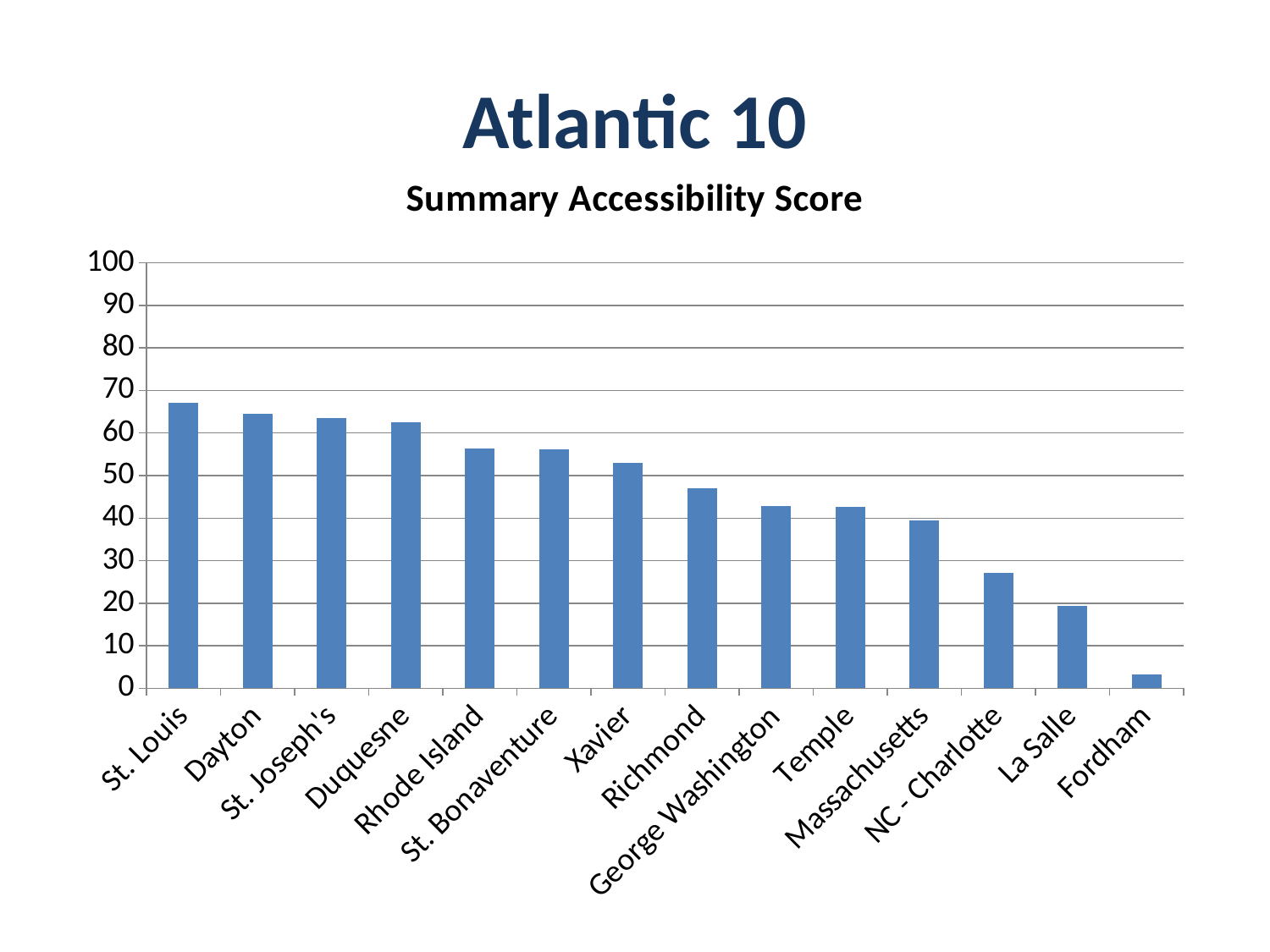
Is the value for Fordham greater or less than 10? less Is the value for Richmond greater or less than 50? less What kind of chart is shown on the slide? bar chart Which school has the lowest Summary Accessibility Score? Fordham Is the value for St. Louis greater or less than 60? greater What is the title of the chart? Summary Accessibility Score Which has a higher Summary Accessibility Score, Massachusetts or Duquesne? Duquesne How many schools are shown on the x axis of the chart? 14 Which school has the highest Summary Accessibility Score? St. Louis Do the values rise or fall moving from left to right along the x axis? fall Which has a higher Summary Accessibility Score, Xavier or Richmond? Xavier